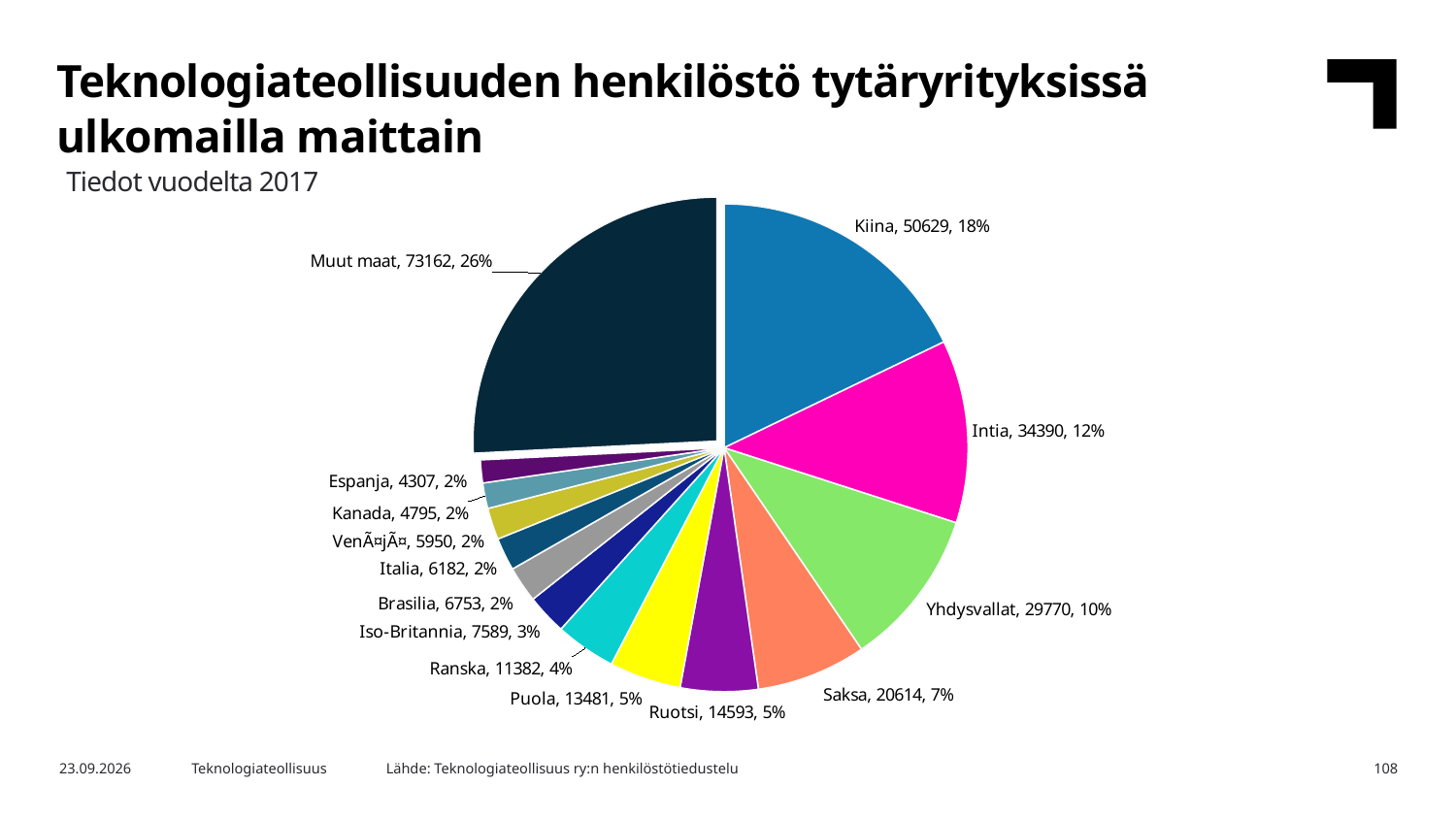
Which slice is the smallest in the pie chart? Espanja What is the value for Yhdysvallat? 29770 What is the value for Saksa? 20614 Which is larger, the value for Intia or the value for Yhdysvallat? Intia What is the difference between the values for Ruotsi and Puola? 1112 What kind of chart is shown on the slide? pie chart What share of the pie does Kiina represent? 18% What is the value for Kiina? 50629 What is the difference between the values for Kiina and Intia? 16239 What year do the data on the slide refer to? 2017 Which slice is the largest in the pie chart? Muut maat How many slices does the pie chart have? 14